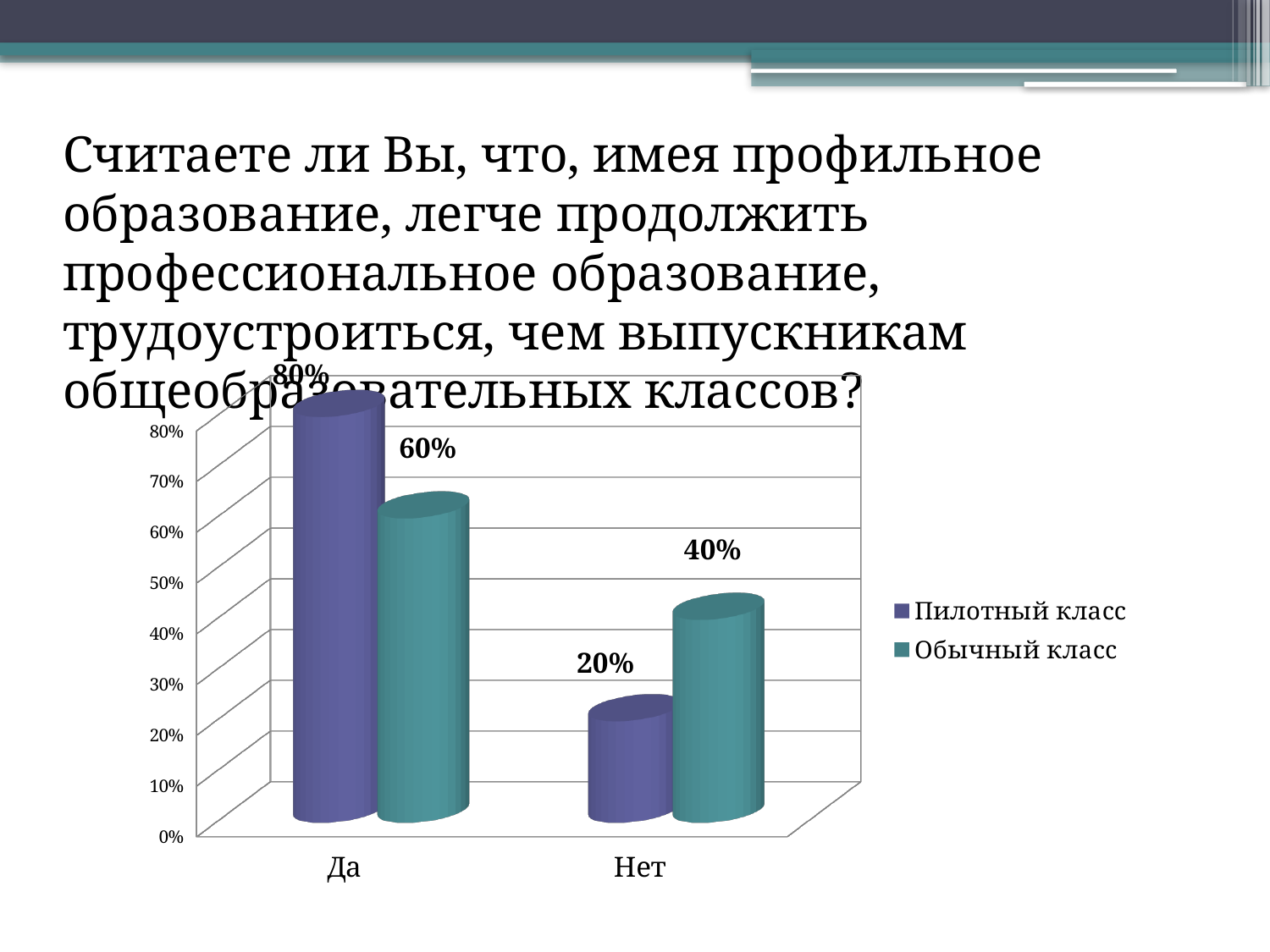
What is the difference between Пилотный класс and Обычный класс in the Да category? 20% How many categories are shown on the x axis? 2 Which category has the lowest value for Обычный класс? Нет In the Нет category, which series has the larger value, Пилотный класс or Обычный класс? Обычный класс What kind of chart is shown on the slide? Bar chart Which series is shown in teal in the legend? Обычный класс What is the value for Обычный класс in the Да category? 60% What is the value for Пилотный класс in the Да category? 80% What is the value for Обычный класс in the Нет category? 40% How many series does the legend list? 2 Which category has the highest value for Пилотный класс? Да What is the value for Пилотный класс in the Нет category? 20%